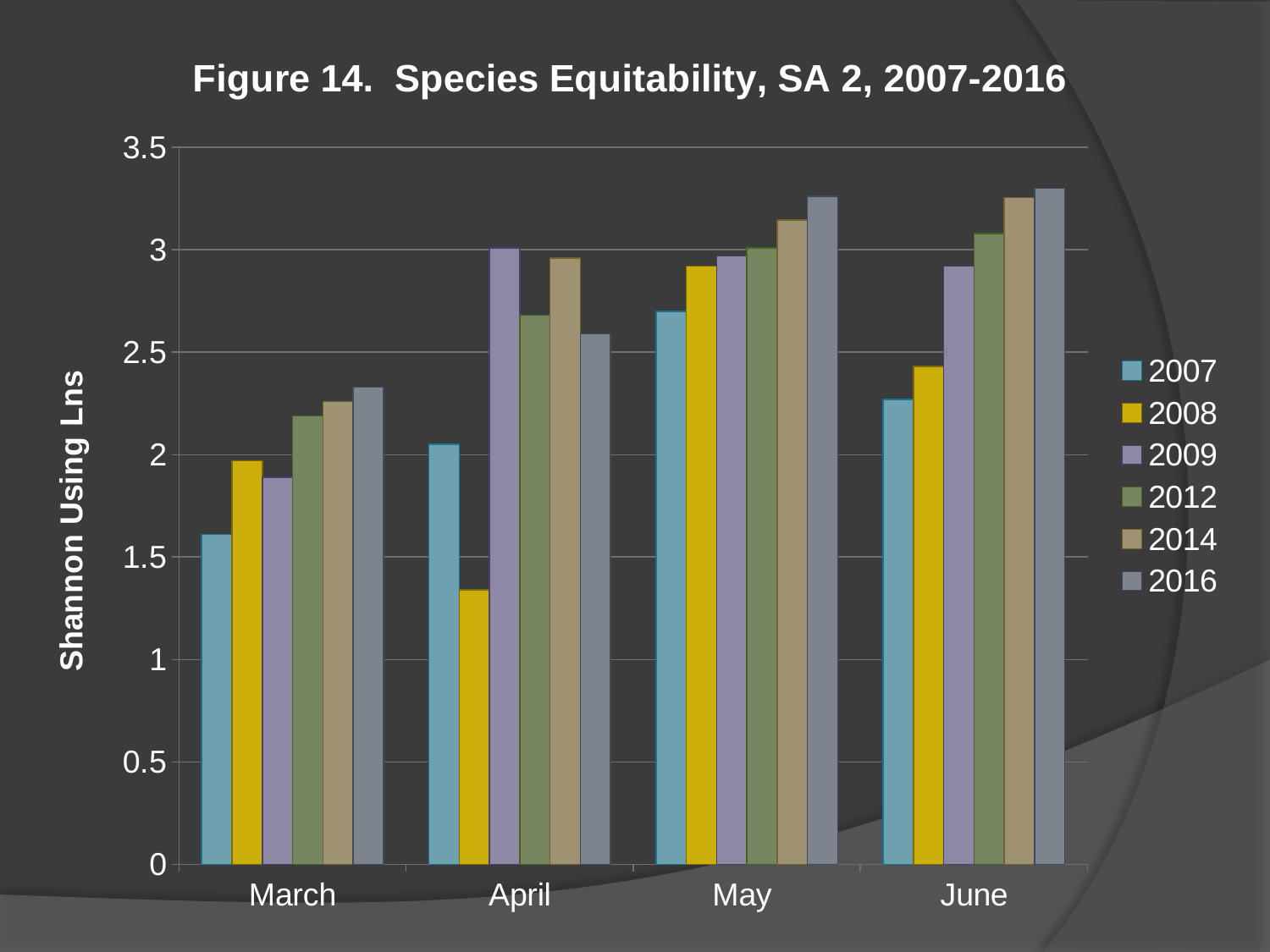
How many series does the legend list? 6 What kind of chart is shown on the slide? bar chart Is the value for 2007 in March greater or less than 2? less How many months are shown on the x axis? 4 Is the value for 2014 in May greater or less than 3? greater In April, which is larger: the value for 2009 or the value for 2012? 2009 Is the value for 2008 in April greater or less than 1.5? less Which year has the lowest value in May? 2007 Do the values for 2016 rise or fall from March to June? rise Which year has the highest value in March? 2016 Which year has the lowest value in April? 2008 What is the title of the y axis? Shannon Using Lns